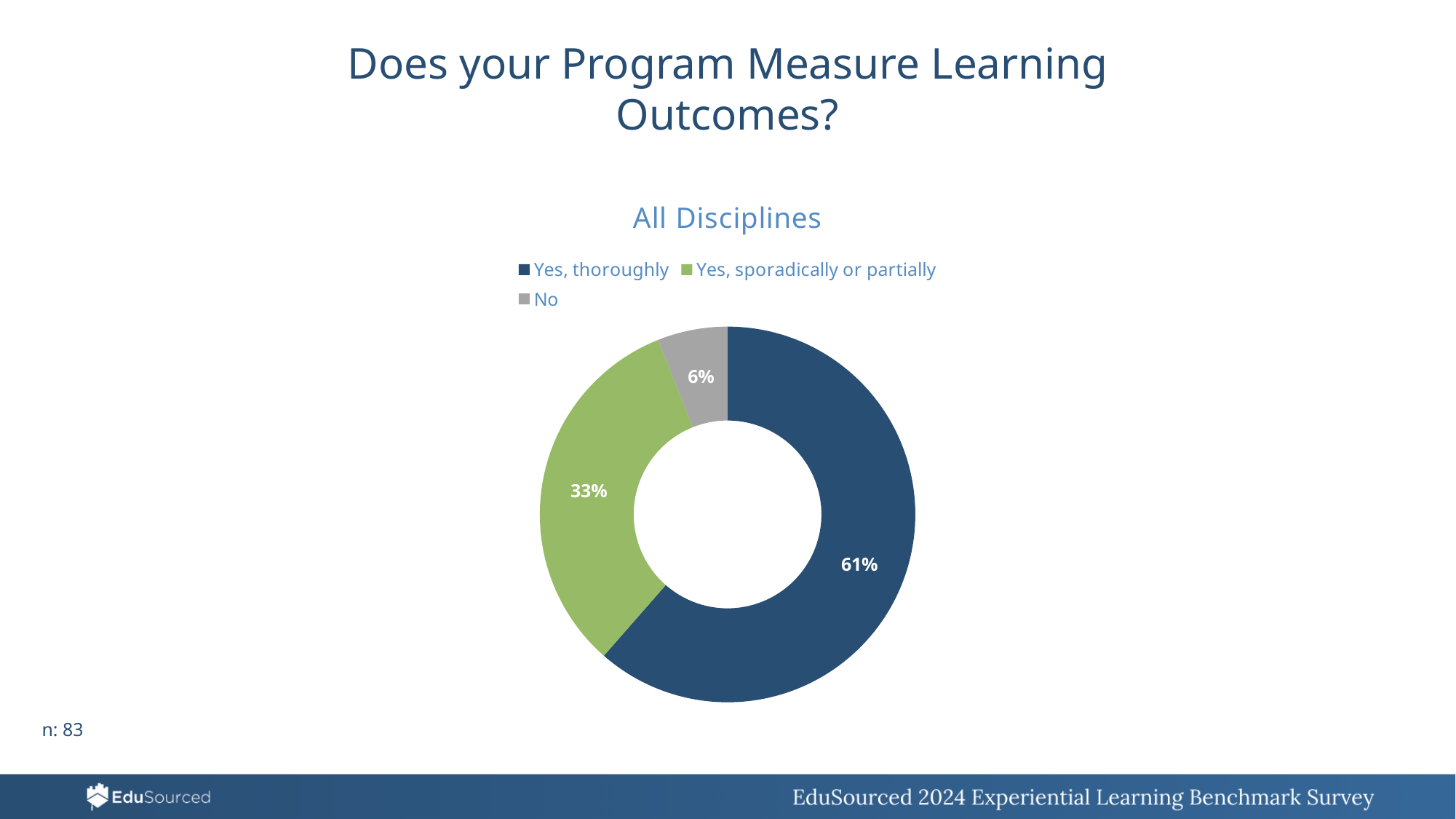
What is the title of the chart? All Disciplines What colour represents the "No" response in the chart? Grey What is the difference in percentage points between "Yes, thoroughly" and "Yes, sporadically or partially"? 28 Which response has the largest share of the chart? Yes, thoroughly What kind of chart is shown on the slide? Pie chart (doughnut) What percentage of respondents answered "Yes, thoroughly"? 61% How many categories does the chart show? 3 Which response has the smallest share of the chart? No What percentage of respondents answered "No"? 6% What percentage of respondents answered "Yes, sporadically or partially"? 33% What is the difference in percentage points between "Yes, sporadically or partially" and "No"? 27 Which is larger: the share for "Yes, sporadically or partially" or the share for "No"? Yes, sporadically or partially